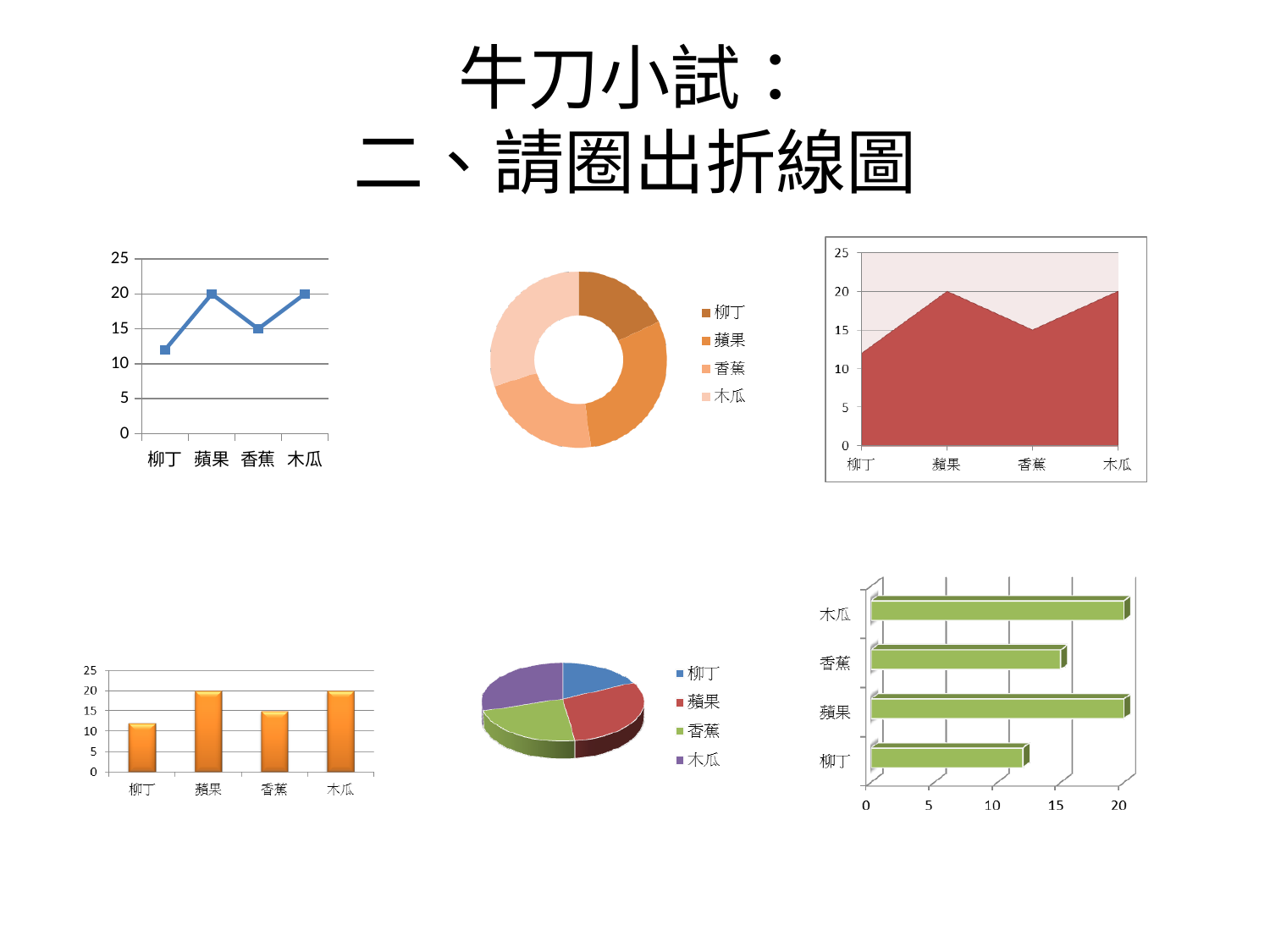
In the top-left line chart, what is the value for 蘋果? 20 How many entries does the legend of the bottom-middle pie chart list? 4 In the top-left line chart, is the value for 柳丁 greater or less than 15? less In the bottom-right horizontal bar chart, which is larger, the value for 蘋果 or the value for 香蕉? 蘋果 In the top-right area chart, is the value for 香蕉 greater or less than 10? greater In the top-left line chart, which category has the lowest value? 柳丁 What kind of chart is the bottom-middle chart on the slide? pie chart In the top-left line chart, is the value for 柳丁 greater or less than 10? greater What kind of chart is the top-left chart on the slide? line chart What kind of chart is the bottom-right chart on the slide? bar chart In the top-left line chart, what is the value for 香蕉? 15 How many categories are shown on the x axis of the bottom-left bar chart? 4